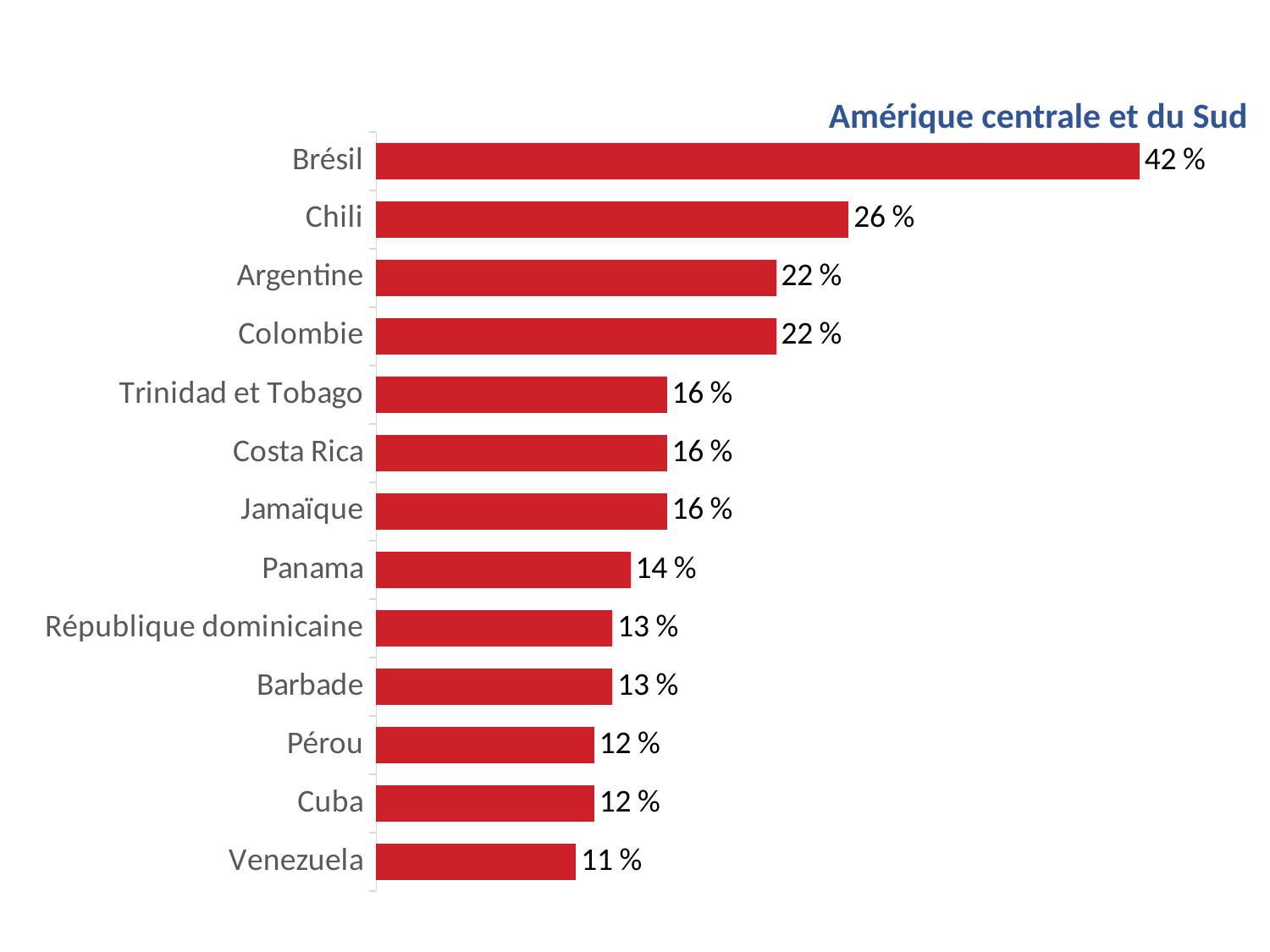
What is the value for Venezuela? 11 % What is the value for Brésil? 42 % What kind of chart is this? Bar chart Which country has the highest value? Brésil Which is larger, the value for Chili or the value for Colombie? Chili Which country has the lowest value? Venezuela What is the difference between the values for Brésil and Chili? 16 % What is the difference between the values for Argentine and Pérou? 10 % How many countries are shown in the chart? 13 What is the value for Panama? 14 % What is the value for Chili? 26 % What is the title of the chart? Amérique centrale et du Sud